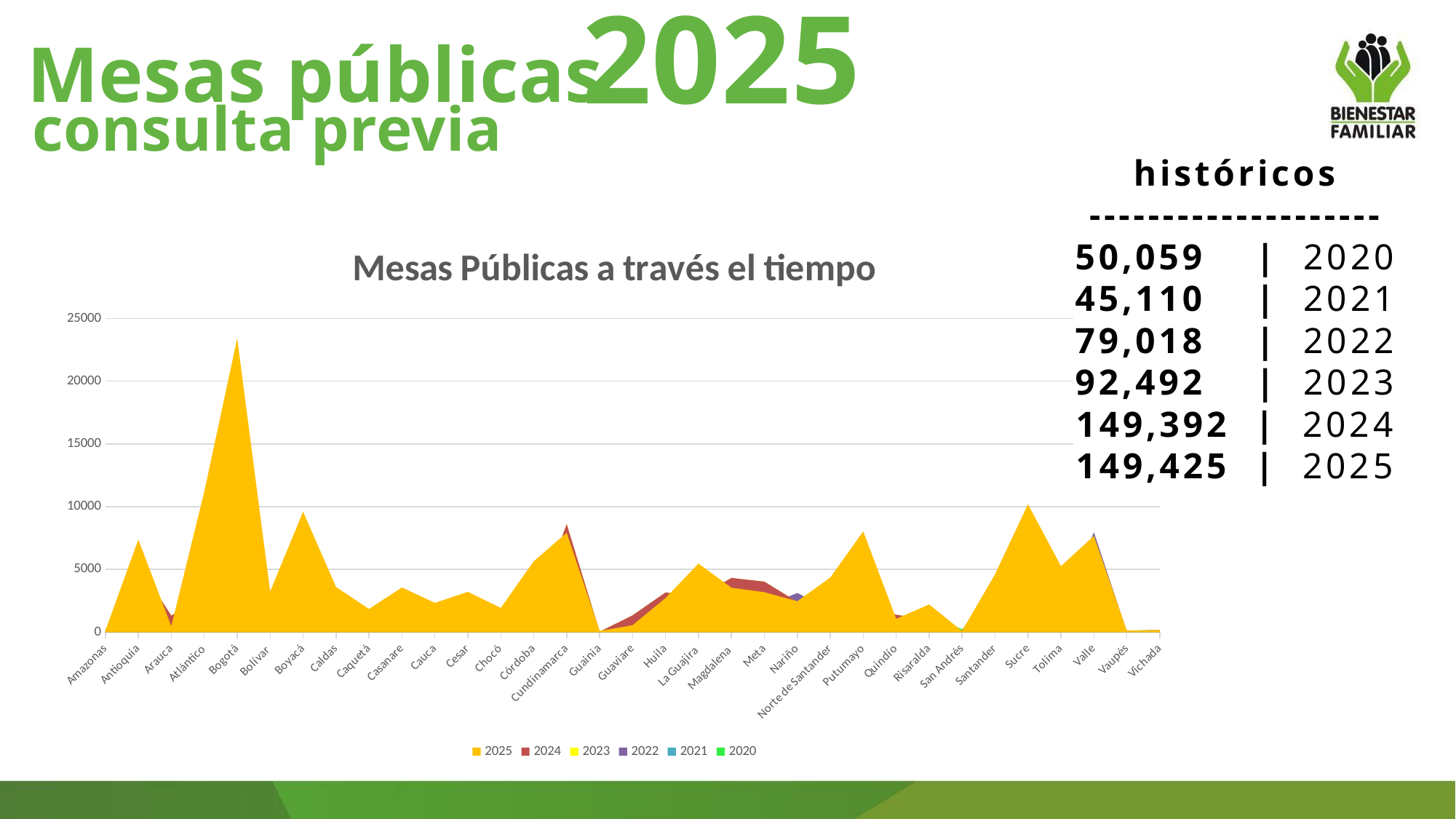
Is the 2025 value for Guainía greater or less than 5000? less Which has the larger 2025 value, Bogotá or Sucre? Bogotá Is the 2025 value for Putumayo greater or less than 5000? greater What kind of chart is "Mesas Públicas a través el tiempo"? Area chart Is the 2025 value for Bogotá greater or less than 20000? greater Which has the larger 2025 value, Antioquia or Arauca? Antioquia How many series does the legend of "Mesas Públicas a través el tiempo" list? 6 What is the title of the chart on the slide? Mesas Públicas a través el tiempo Which department has the highest 2025 value in "Mesas Públicas a través el tiempo"? Bogotá How many categories (departments) are shown on the x axis of "Mesas Públicas a través el tiempo"? 33 Which series is shown in orange/yellow in the chart legend? 2025